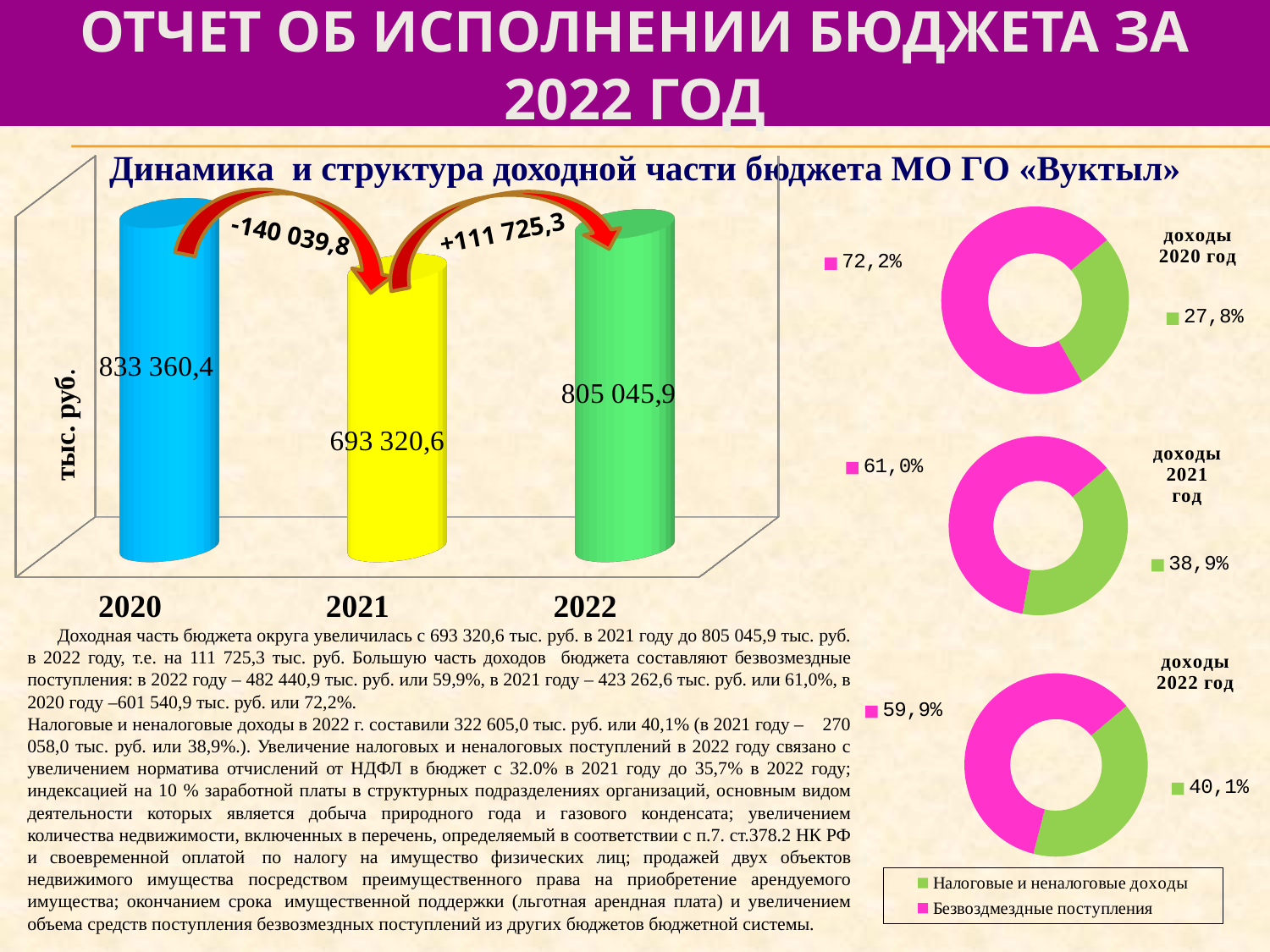
In the bar chart 'Динамика и структура доходной части бюджета МО ГО «Вуктыл»', which year has the highest value? 2020 In the bar chart 'Динамика и структура доходной части бюджета МО ГО «Вуктыл»', what is the value for 2021? 693 320,6 In the bar chart 'Динамика и структура доходной части бюджета МО ГО «Вуктыл»', which is larger, the value for 2020 or the value for 2022? 2020 In the bar chart 'Динамика и структура доходной части бюджета МО ГО «Вуктыл»', what is the value for 2022? 805 045,9 In the bar chart 'Динамика и структура доходной части бюджета МО ГО «Вуктыл»', what is the value for 2020? 833 360,4 In the bar chart 'Динамика и структура доходной части бюджета МО ГО «Вуктыл»', what is the difference between the 2022 value and the 2021 value? 111 725,3 What kind of chart is the chart on the left of the slide showing values for 2020, 2021 and 2022? Bar chart In the bar chart 'Динамика и структура доходной части бюджета МО ГО «Вуктыл»', which year has the lowest value? 2021 In the donut chart 'доходы 2021 год', what share is Налоговые и неналоговые доходы? 38,9% In the donut chart 'доходы 2020 год', what share is Безвозмездные поступления? 72,2% In the bar chart 'Динамика и структура доходной части бюджета МО ГО «Вуктыл»', how many years are shown? 3 In the donut chart 'доходы 2022 год', what share is Безвозмездные поступления? 59,9%